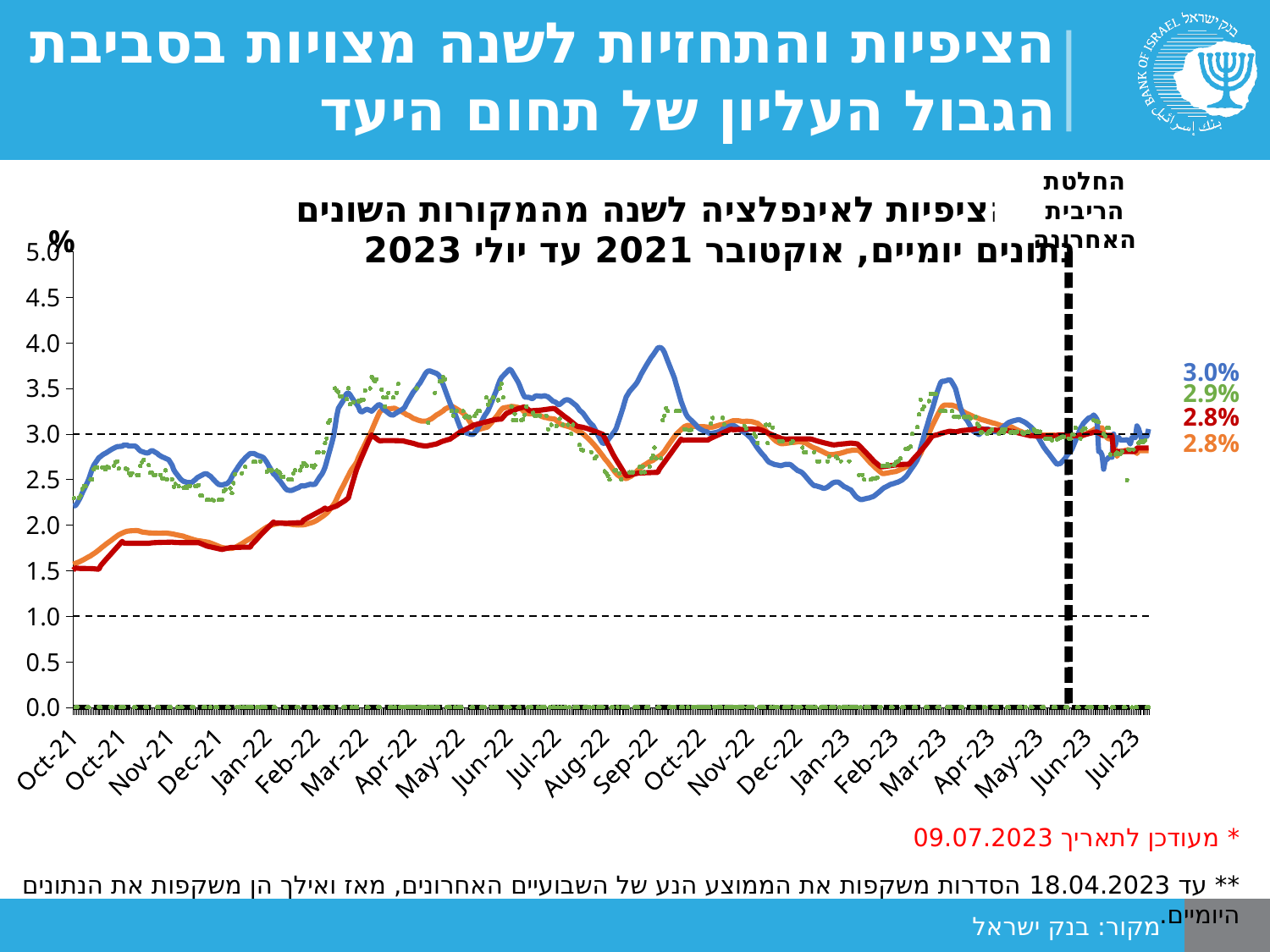
What is the latest value labelled for the green dotted line at the right end of the chart? 2.9% Do the red and orange lines rise or fall between Oct-21 and Apr-22? rise Is the peak of the blue line around Sep-22 greater or less than 3.5? greater What is the latest value labelled for the blue line at the right end of the chart? 3.0% What does the vertical dashed line on the chart mark, according to its label? החלטת הריבית האחרונה (the last interest rate decision) What is the latest value labelled for the red line at the right end of the chart? 2.8% Which line has the highest labelled end value? the blue line (3.0%) Is the value of the red line at Oct-21 greater or less than 2.0? less What is the latest value labelled for the orange line at the right end of the chart? 2.8% What kind of chart is shown on the slide? line chart What is the difference between the labelled end values of the blue line and the red line? 0.2%